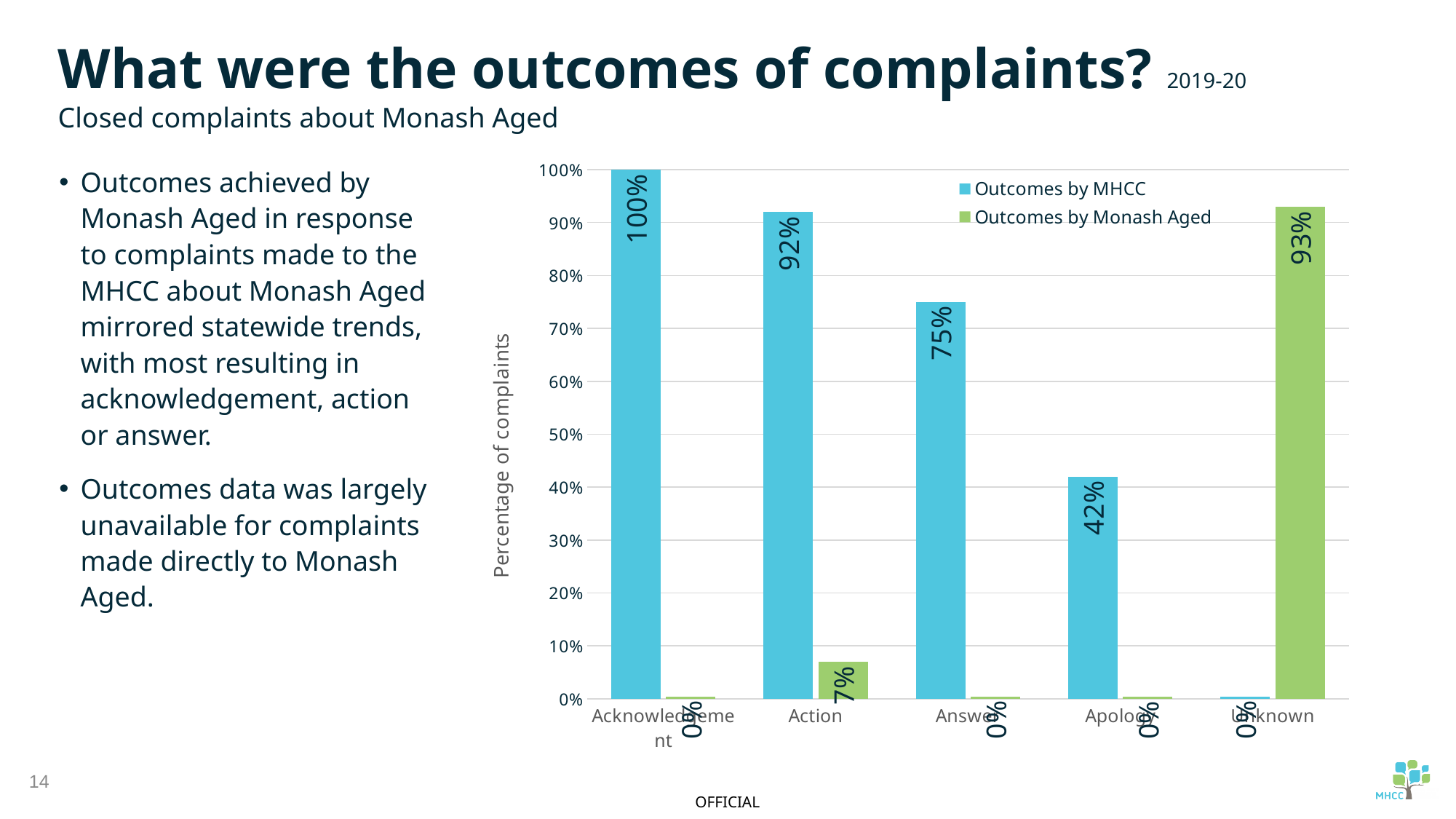
How many series does the legend list? 2 Is the value for Outcomes by MHCC in the Action category greater or less than 80%? greater Which is larger: Outcomes by MHCC for Answer or Outcomes by MHCC for Apology? Answer What is the value for Outcomes by MHCC in the Apology category? 42% Which category has the lowest value for Outcomes by MHCC? Unknown What is the value for Outcomes by Monash Aged in the Action category? 7% What is the difference between the Outcomes by MHCC values for Action and Answer? 17% Which category has the highest value for Outcomes by MHCC? Acknowledgement What is the value for Outcomes by Monash Aged in the Unknown category? 93% How many categories are shown on the x axis? 5 What is the value for Outcomes by MHCC in the Acknowledgement category? 100% What kind of chart is shown on the slide? Bar chart